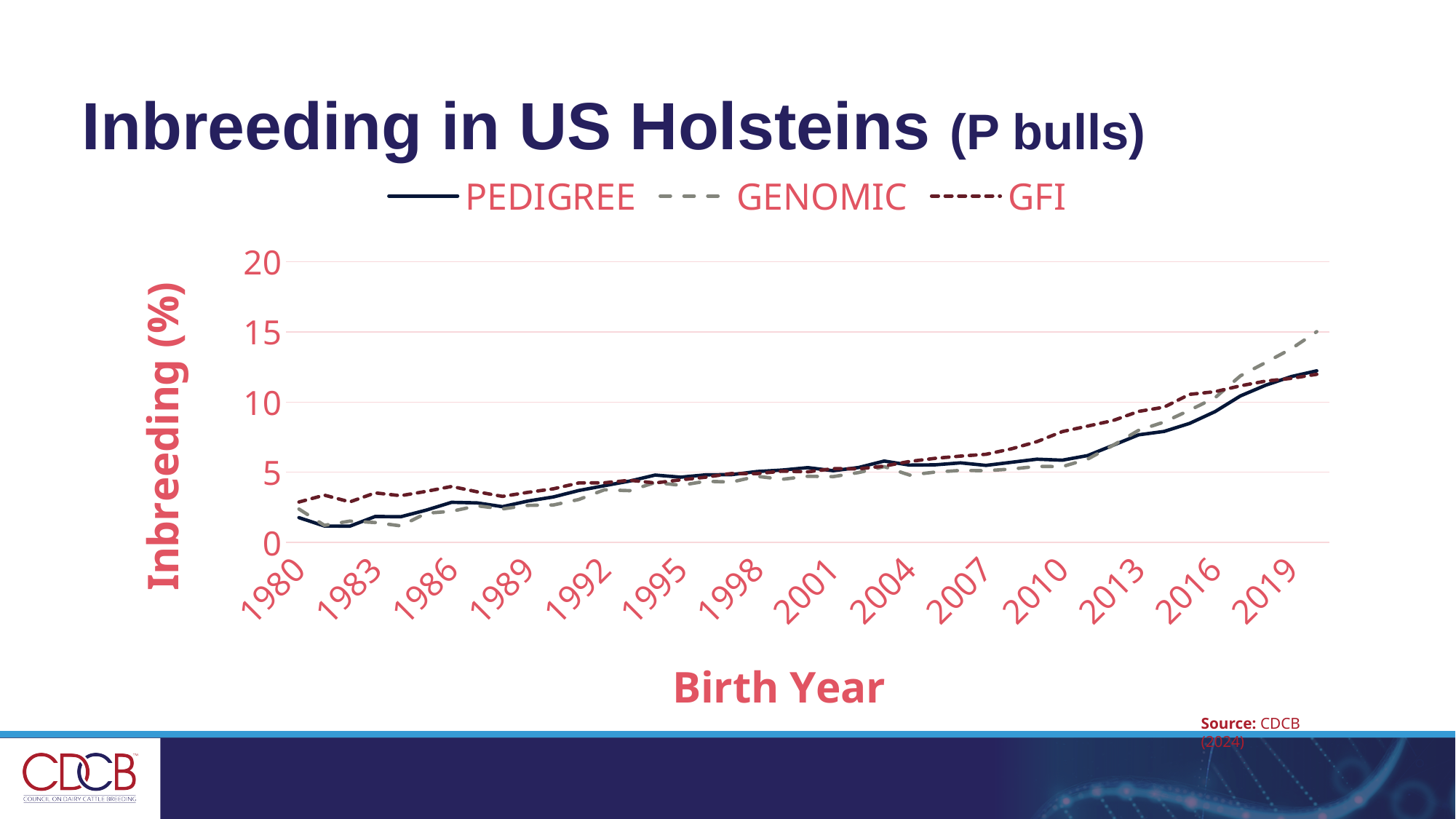
Is the GFI value at 2010 greater or less than 5? greater Is the GENOMIC value at 2019 greater or less than 10? greater Is the PEDIGREE value at 1980 greater or less than 5? less What is the label of the y axis? Inbreeding (%) At 1980, which series has the higher value, GFI or PEDIGREE? GFI How many birth-year labels are shown on the x axis? 14 Do the PEDIGREE values rise or fall from 1980 to 2019? Rise How many series does the legend list? 3 At 2019, which series has the higher value, GENOMIC or PEDIGREE? GENOMIC What kind of chart is shown on the slide? Line chart What is the title of the chart on the slide? Inbreeding in US Holsteins (P bulls)